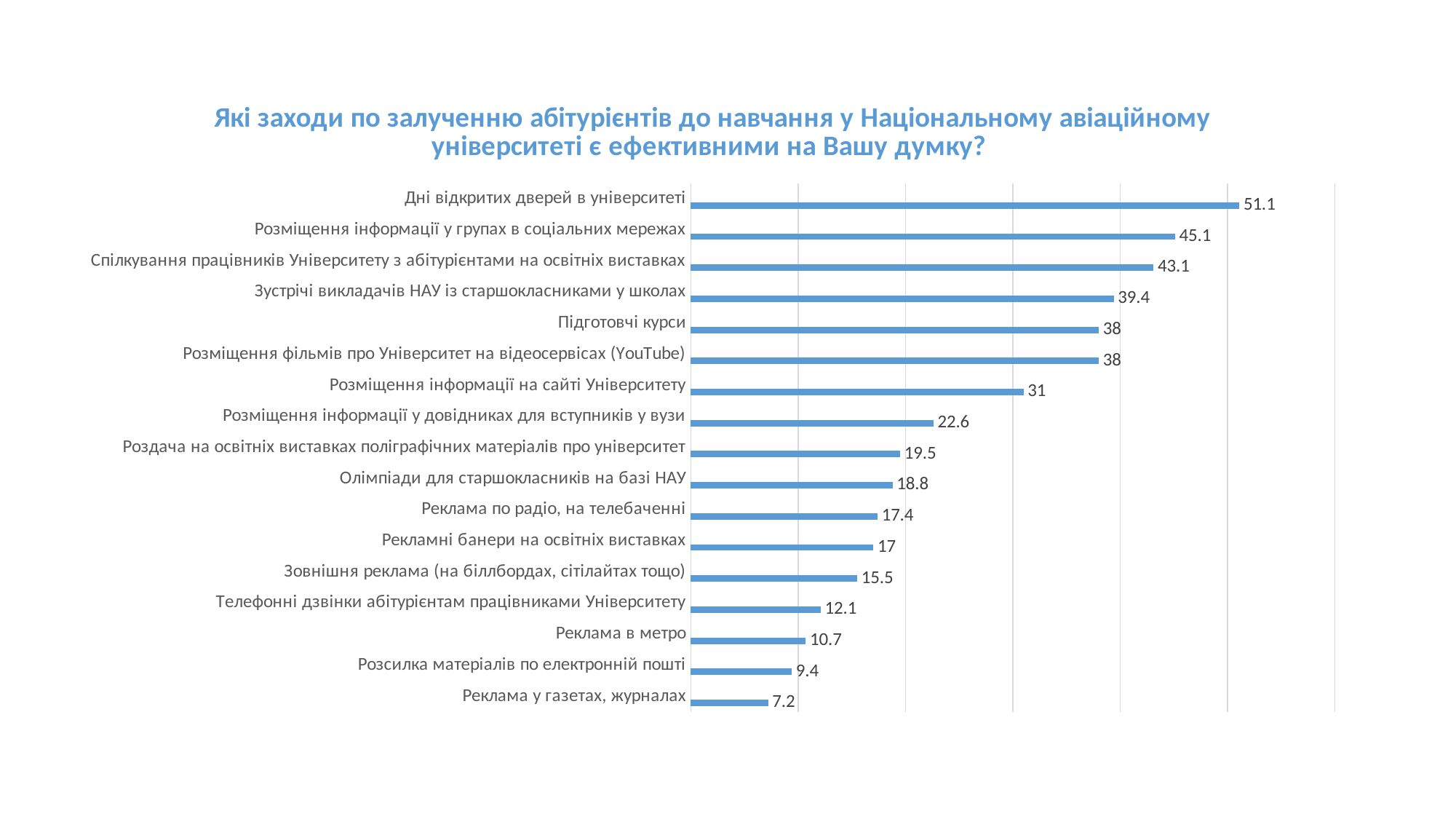
Which category has the highest value? Дні відкритих дверей в університеті How many categories are shown in the chart? 17 What kind of chart is shown on the slide? Bar chart What is the difference between the values for "Дні відкритих дверей в університеті" and "Розміщення інформації у групах в соціальних мережах"? 6 Which category has the lowest value? Реклама у газетах, журналах Which two categories share the same value of 38? Підготовчі курси and Розміщення фільмів про Університет на відеосервісах (YouTube) What is the value for "Розміщення інформації на сайті Університету"? 31 Which is larger: the value for "Зустрічі викладачів НАУ із старшокласниками у школах" or the value for "Підготовчі курси"? Зустрічі викладачів НАУ із старшокласниками у школах What is the value for "Реклама в метро"? 10.7 Which is larger: the value for "Реклама по радіо, на телебаченні" or the value for "Телефонні дзвінки абітурієнтам працівниками Університету"? Реклама по радіо, на телебаченні What is the difference between the values for "Розміщення інформації у довідниках для вступників у вузи" and "Реклама у газетах, журналах"? 15.4 What is the value for "Дні відкритих дверей в університеті"? 51.1